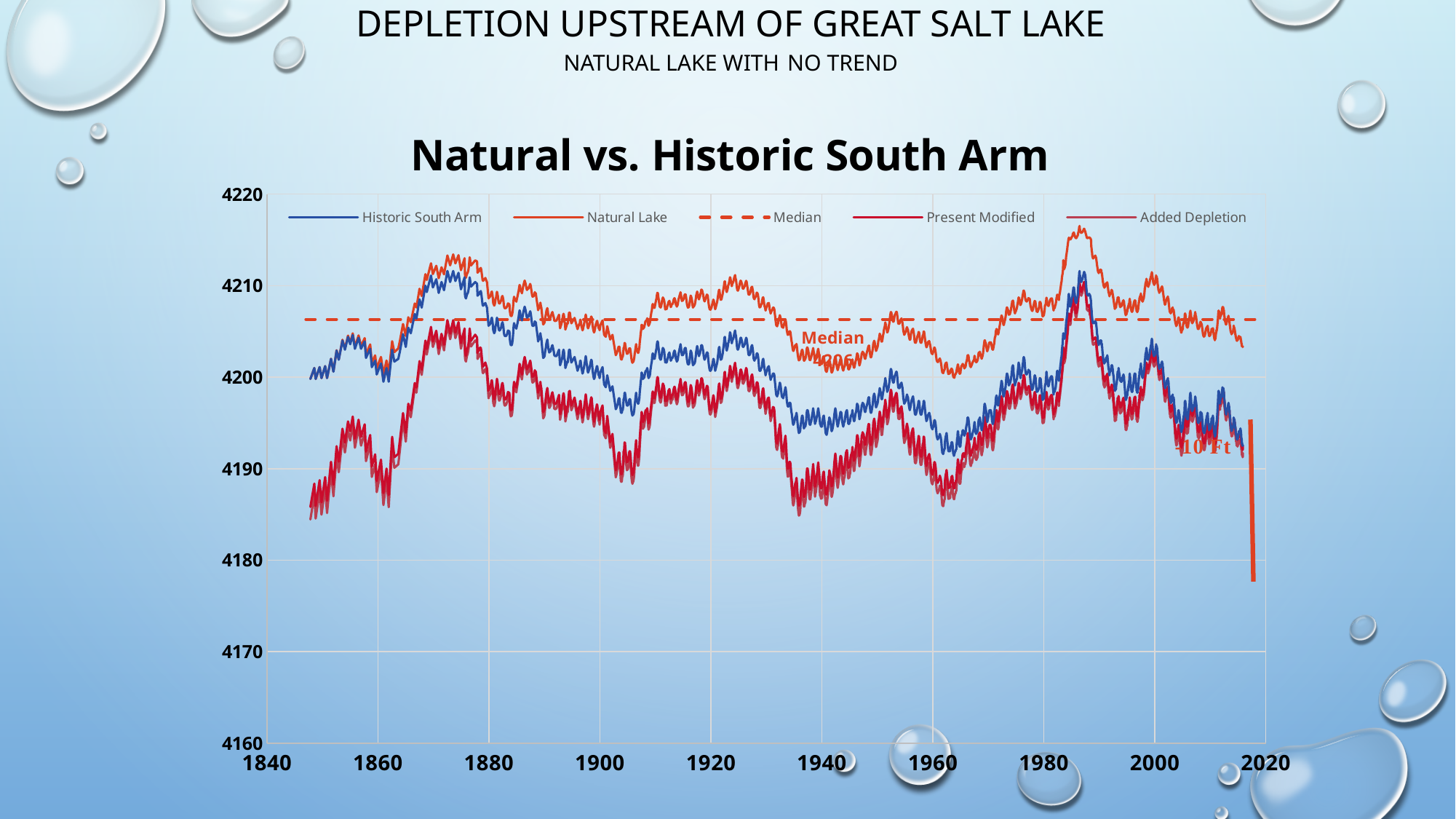
Is the Present Modified value around 1935 greater or less than 4190? less What kind of chart is shown on the slide? line chart Does the Natural Lake series rise or fall between 2000 and 2018? fall Is the Median line greater or less than 4200? greater What is the title of the chart? Natural vs. Historic South Arm Is the Historic South Arm value around 1935 greater or less than 4200? less Around 1920, which is higher: the Natural Lake series or the Historic South Arm series? Natural Lake Which series reaches the highest value on the chart? Natural Lake Does the Historic South Arm series rise or fall between 1962 and 1985? rise Which legend entry is drawn as a dashed line? Median How many series does the legend of the chart list? 5